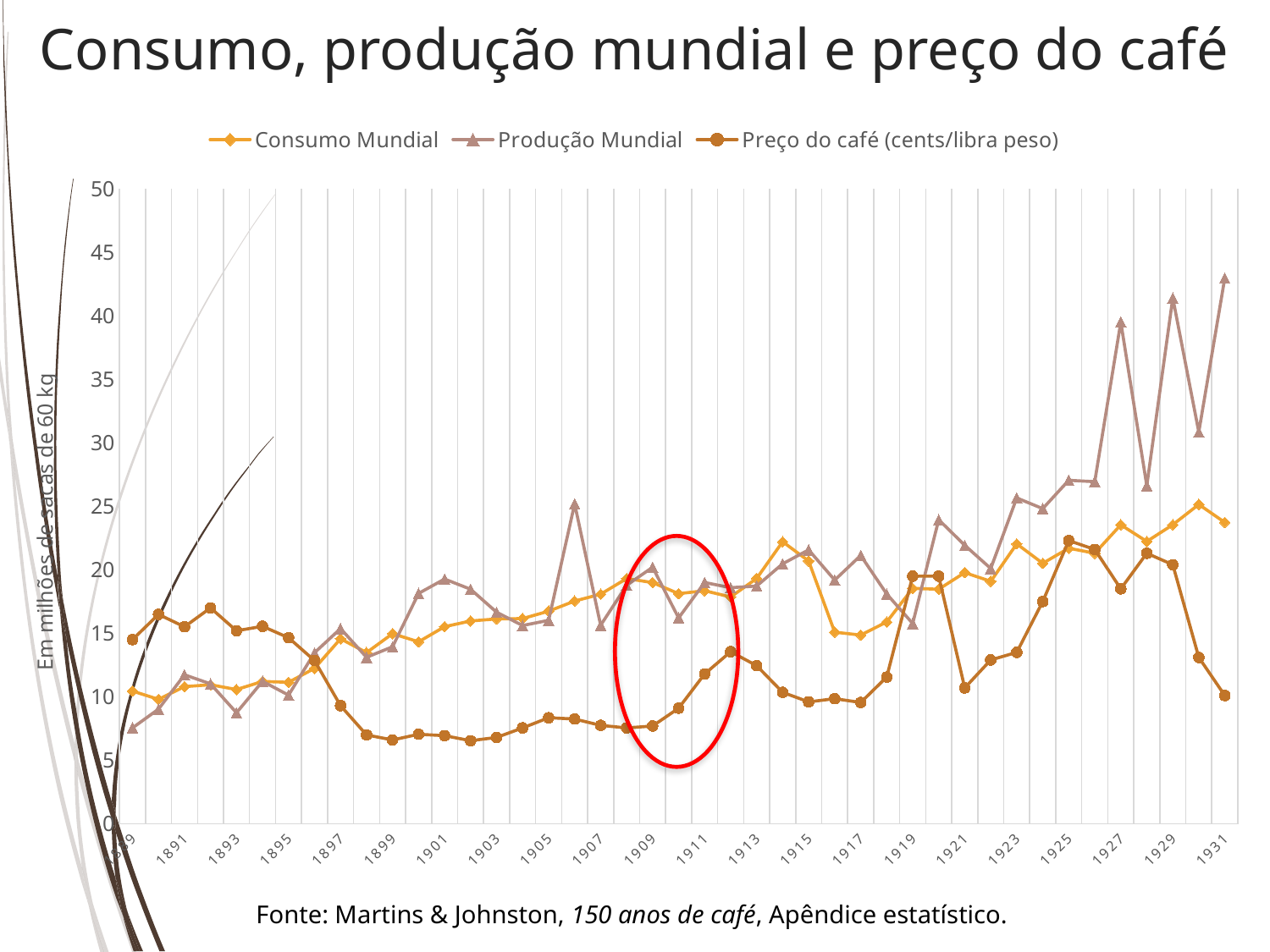
Does Consumo Mundial generally rise or fall from 1889 to 1931? Rise How many series does the legend list? 3 In 1931, which is larger: Produção Mundial or Consumo Mundial? Produção Mundial In 1889, which is larger: Preço do café (cents/libra peso) or Consumo Mundial? Preço do café (cents/libra peso) What is the title of the chart? Consumo, produção mundial e preço do café What is the label on the vertical axis? Em milhões de sacas de 60 kg Which series reaches the highest value anywhere on the chart? Produção Mundial Is the value for Preço do café (cents/libra peso) in 1931 greater or less than 15? less Is the value for Produção Mundial in 1931 greater or less than 40? greater Is the value for Consumo Mundial in 1889 greater or less than 15? less What kind of chart is shown on the slide? Line chart